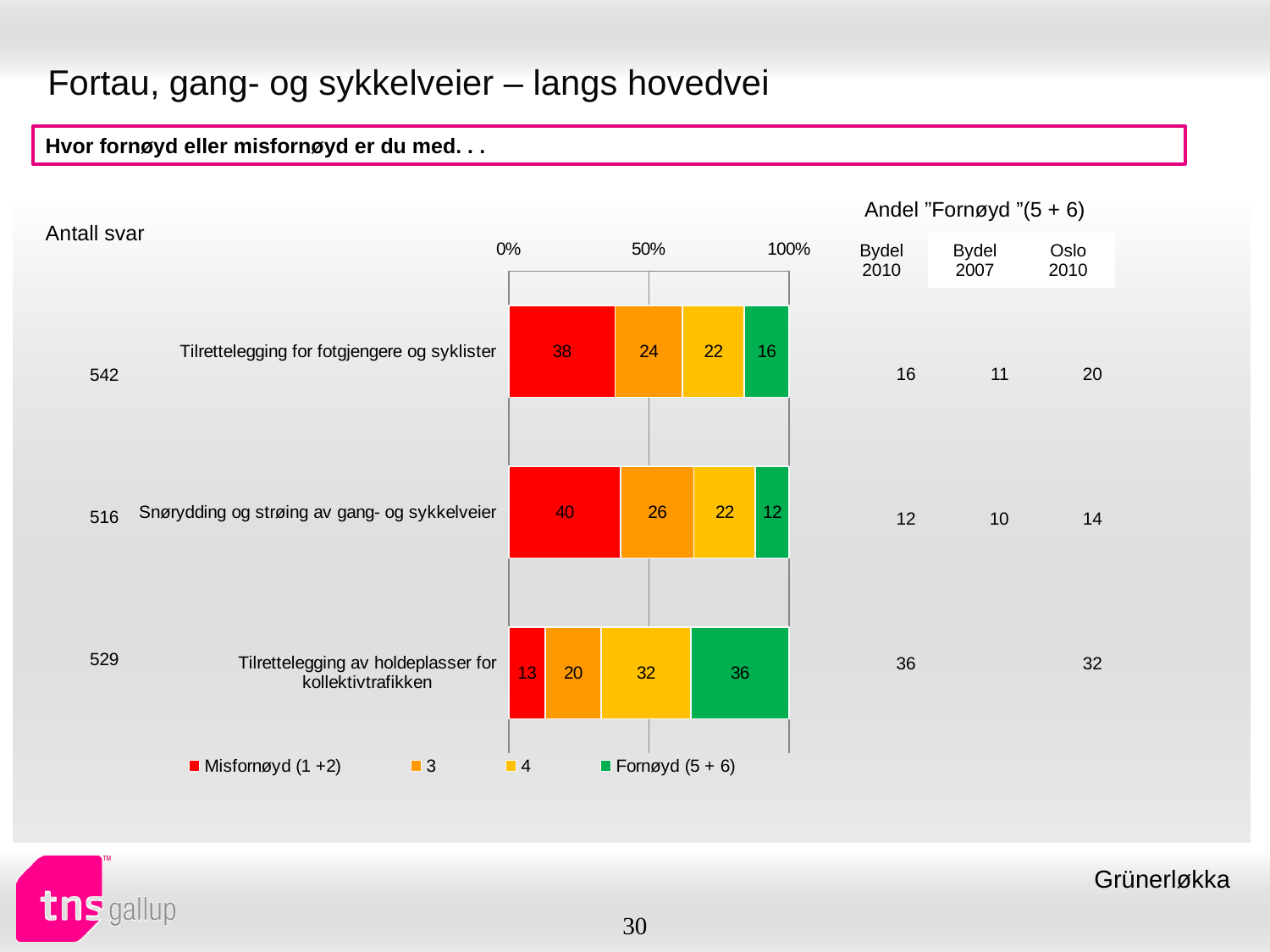
Which category has the lowest Misfornøyd (1 +2) value? Tilrettelegging av holdeplasser for kollektivtrafikken What is the difference between the Misfornøyd (1 +2) values for "Snørydding og strøing av gang- og sykkelveier" and "Tilrettelegging av holdeplasser for kollektivtrafikken"? 27 How many categories are shown in the chart? 3 What kind of chart is shown on the slide? Stacked bar chart Which is larger: the "3" segment for "Snørydding og strøing av gang- og sykkelveier" or the "3" segment for "Tilrettelegging for fotgjengere og syklister"? Snørydding og strøing av gang- og sykkelveier What is the value of the Fornøyd (5 + 6) segment for "Snørydding og strøing av gang- og sykkelveier"? 12 What is the total of the stacked bar for "Tilrettelegging for fotgjengere og syklister"? 100 Which category has the highest Fornøyd (5 + 6) value? Tilrettelegging av holdeplasser for kollektivtrafikken How many series does the legend list? 4 What is the value of the Misfornøyd (1 +2) segment for "Tilrettelegging for fotgjengere og syklister"? 38 What is the value of the "4" segment for "Tilrettelegging av holdeplasser for kollektivtrafikken"? 32 What colour represents the Fornøyd (5 + 6) series in the chart? Green